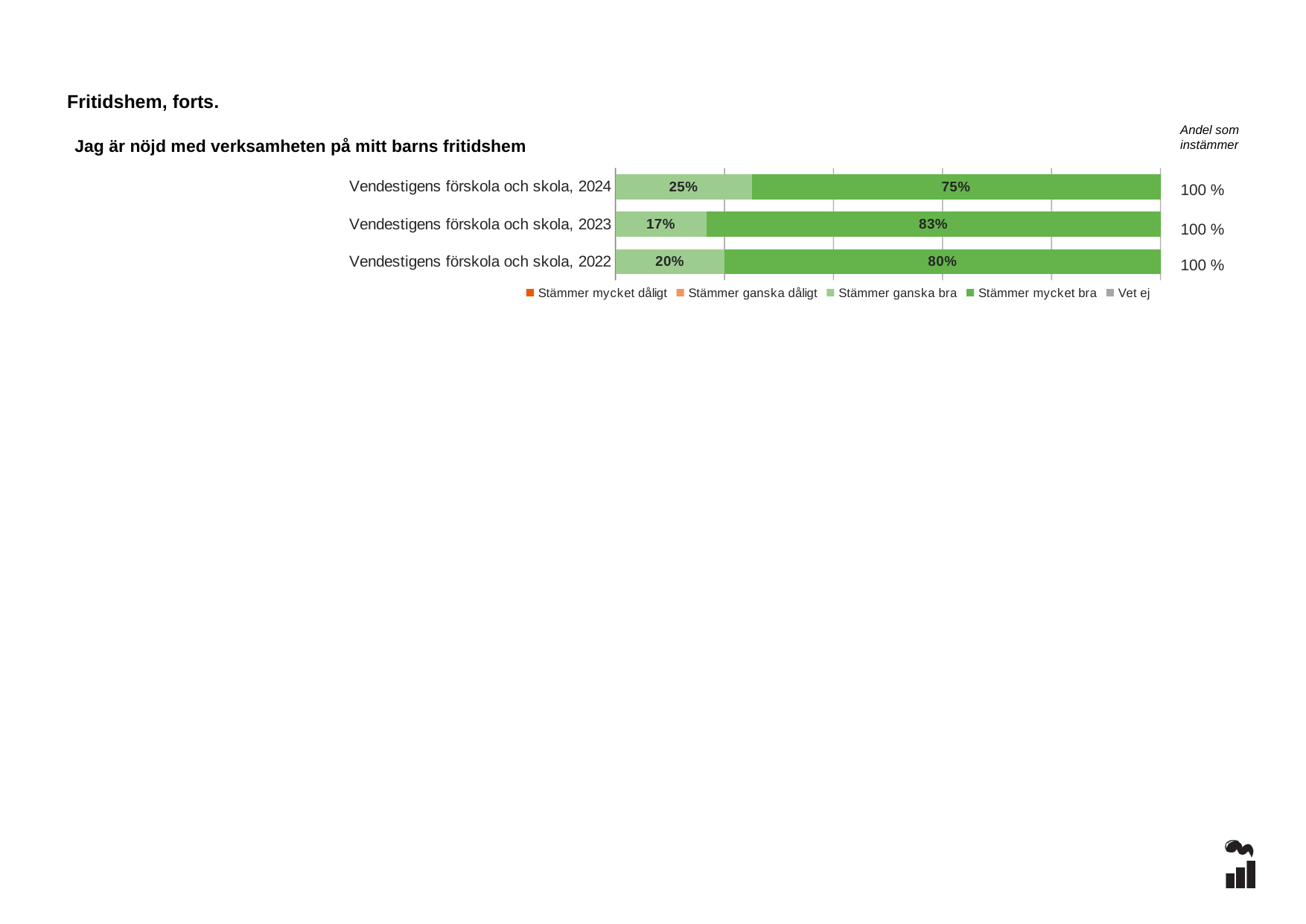
What is the title of the chart? Jag är nöjd med verksamheten på mitt barns fritidshem Which year has the lowest share of 'Stämmer mycket bra' responses? 2024 How many bars (years) are shown in the chart? 3 What percentage of respondents answered 'Stämmer ganska bra' for Vendestigens förskola och skola, 2023? 17% What percentage of respondents answered 'Stämmer mycket bra' for Vendestigens förskola och skola, 2022? 80% What is the 'Andel som instämmer' value shown for Vendestigens förskola och skola, 2023? 100 % What is the difference in the 'Stämmer mycket bra' share between 2023 and 2024? 8 percentage points What type of chart is shown on the slide? Stacked bar chart How many response categories does the legend list? 5 What percentage of respondents answered 'Stämmer mycket bra' for Vendestigens förskola och skola, 2024? 75% Is the 'Stämmer ganska bra' share larger in 2024 or in 2022? 2024 Which year has the highest share of 'Stämmer mycket bra' responses? 2023